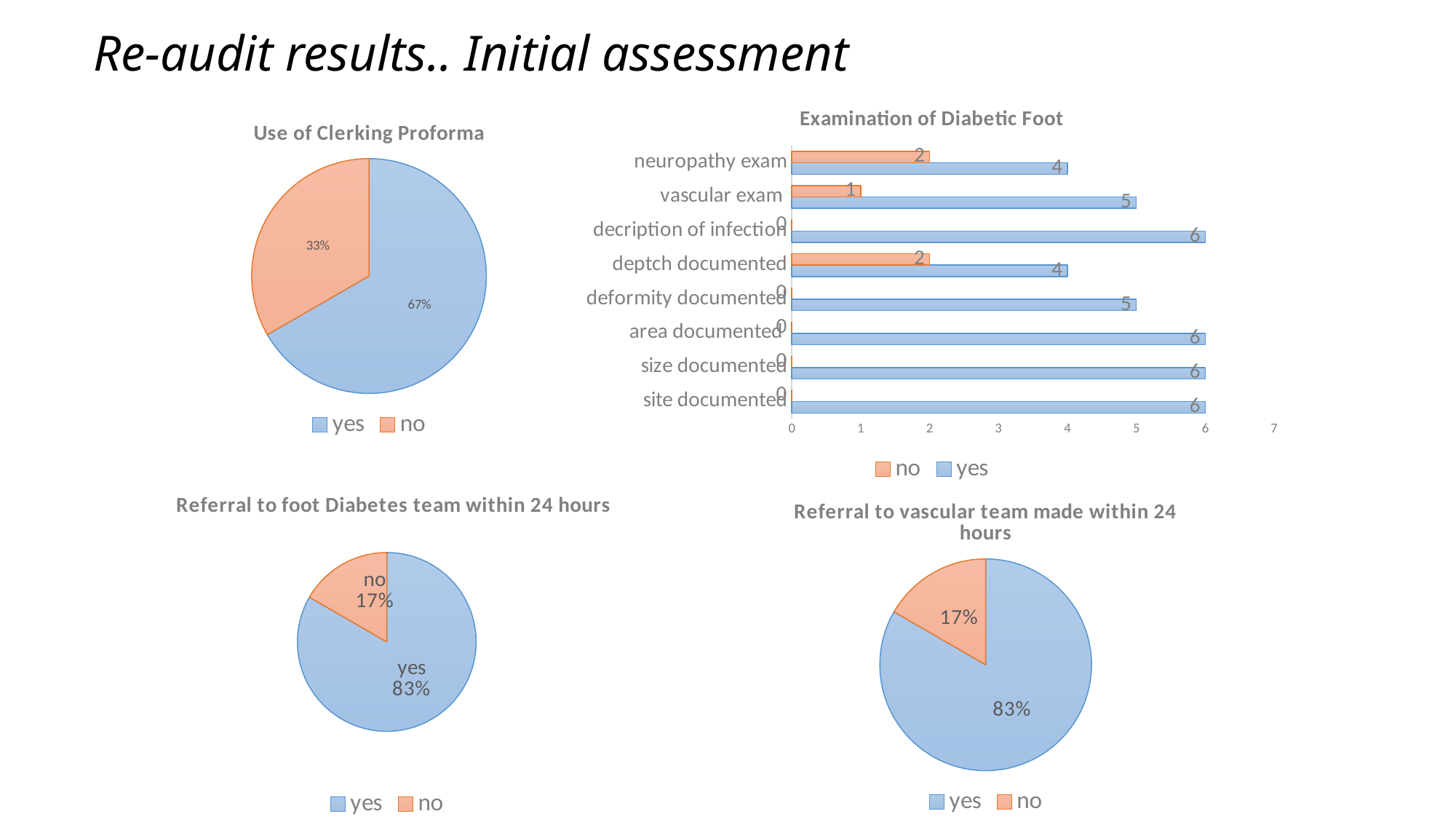
In the 'Examination of Diabetic Foot' chart, what is the 'no' value for 'neuropathy exam'? 2 In the 'Examination of Diabetic Foot' chart, which is larger: the 'yes' value for 'vascular exam' or the 'yes' value for 'neuropathy exam'? vascular exam In the 'Use of Clerking Proforma' pie chart, which colour represents 'no'? orange In the 'Examination of Diabetic Foot' chart, how many series does the legend list? 2 What kind of chart is 'Examination of Diabetic Foot'? bar chart In the 'Use of Clerking Proforma' pie chart, what percentage is shown for 'yes'? 67% In the 'Examination of Diabetic Foot' chart, what is the 'yes' value for 'vascular exam'? 5 In the 'Referral to vascular team made within 24 hours' pie chart, what percentage is shown for 'yes'? 83% In the 'Referral to foot Diabetes team within 24 hours' pie chart, what percentage is shown for 'no'? 17% In the 'Examination of Diabetic Foot' chart, what is the difference between the 'yes' and 'no' values for 'deptch documented'? 2 In the 'Examination of Diabetic Foot' chart, how many categories are listed on the vertical axis? 8 In the 'Use of Clerking Proforma' pie chart, what percentage is shown for 'no'? 33%